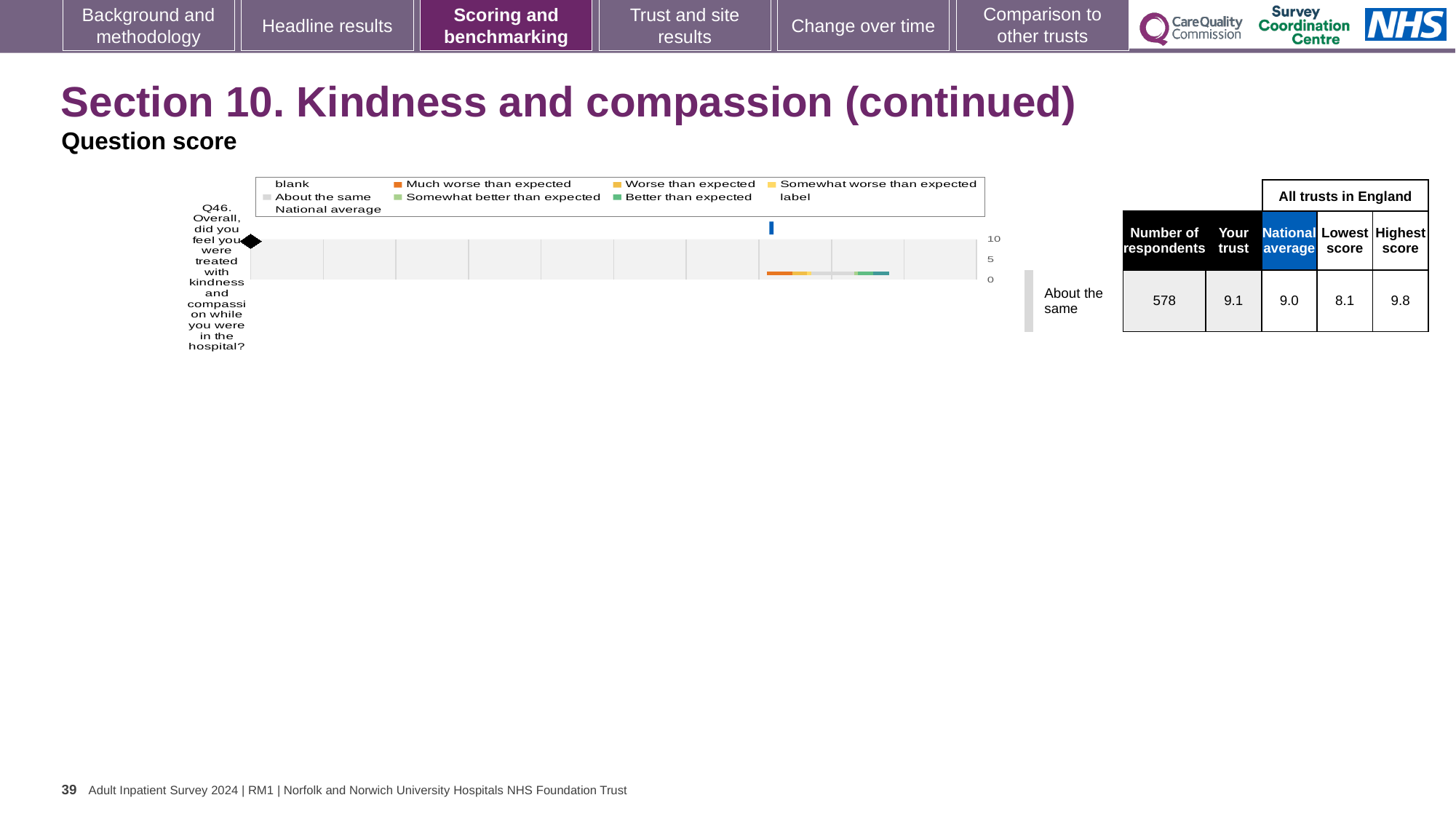
How many survey questions are plotted in the chart? 1 Which is larger for Q46, the 'Your trust' score or the national average? Your trust Which question number is plotted in the chart? Q46 What is the number of respondents for Q46? 578 What is the lowest score among all trusts in England for Q46? 8.1 What is the national average score for Q46? 9.0 What is the difference between the 'Your trust' score and the national average for Q46? 0.1 What is the 'Your trust' score for Q46? 9.1 What benchmark category is the trust's Q46 score placed in? About the same What is the highest score among all trusts in England for Q46? 9.8 What is the difference between the highest and lowest scores for Q46? 1.7 What type of chart is shown on the slide? bar chart